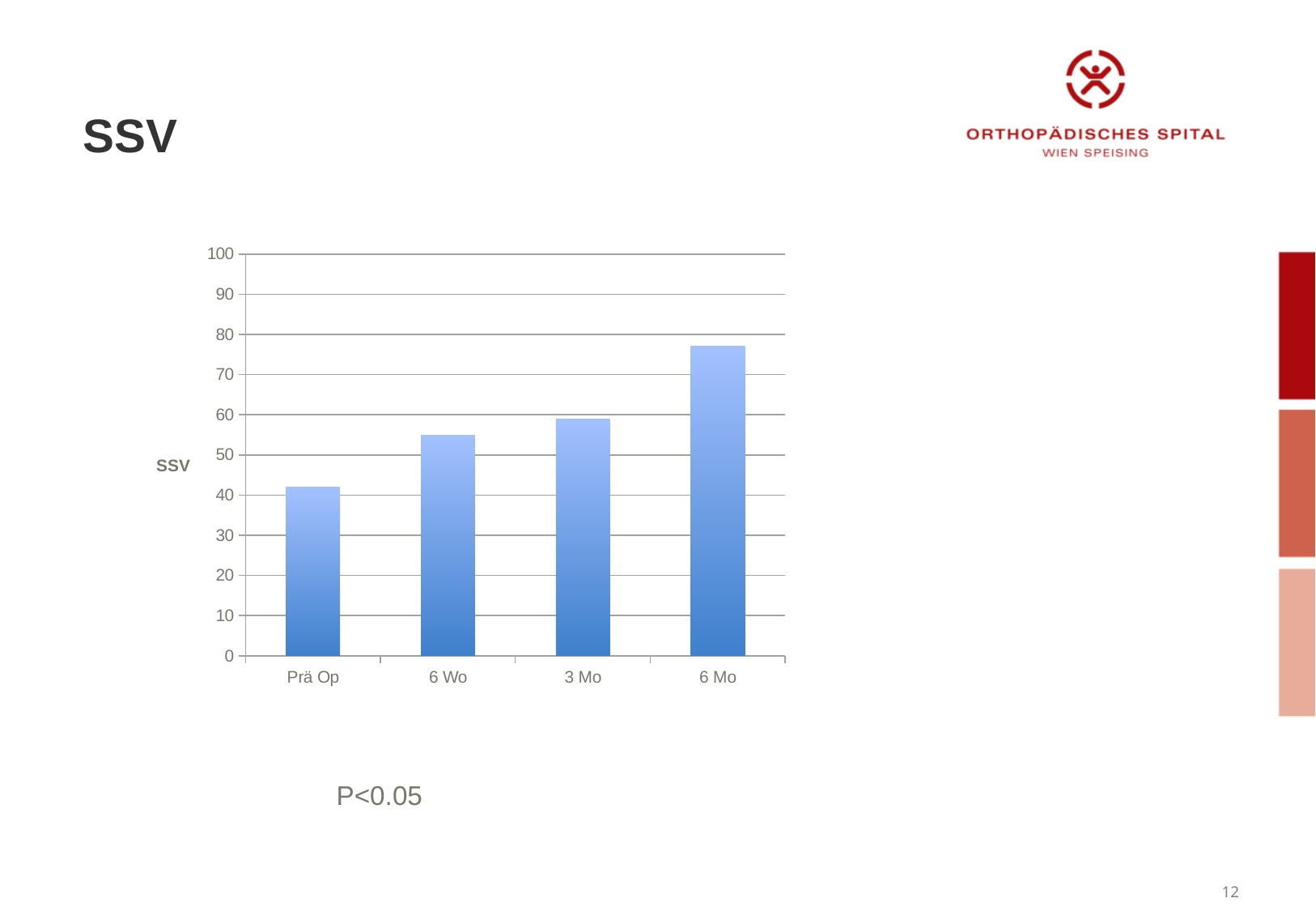
Which category has the lowest SSV value? Prä Op Is the value for 6 Mo greater or less than 70? greater Which is larger, the value for Prä Op or the value for 6 Mo? 6 Mo Do the SSV values rise or fall from Prä Op to 6 Mo? rise Is the value for Prä Op greater or less than 50? less How many categories are shown on the x axis of the chart? 4 Is the value for 6 Mo greater or less than 80? less What kind of chart is shown on the slide? bar chart What is the label on the vertical axis of the chart? SSV Which category has the highest SSV value? 6 Mo Which is larger, the value for 6 Wo or the value for 6 Mo? 6 Mo